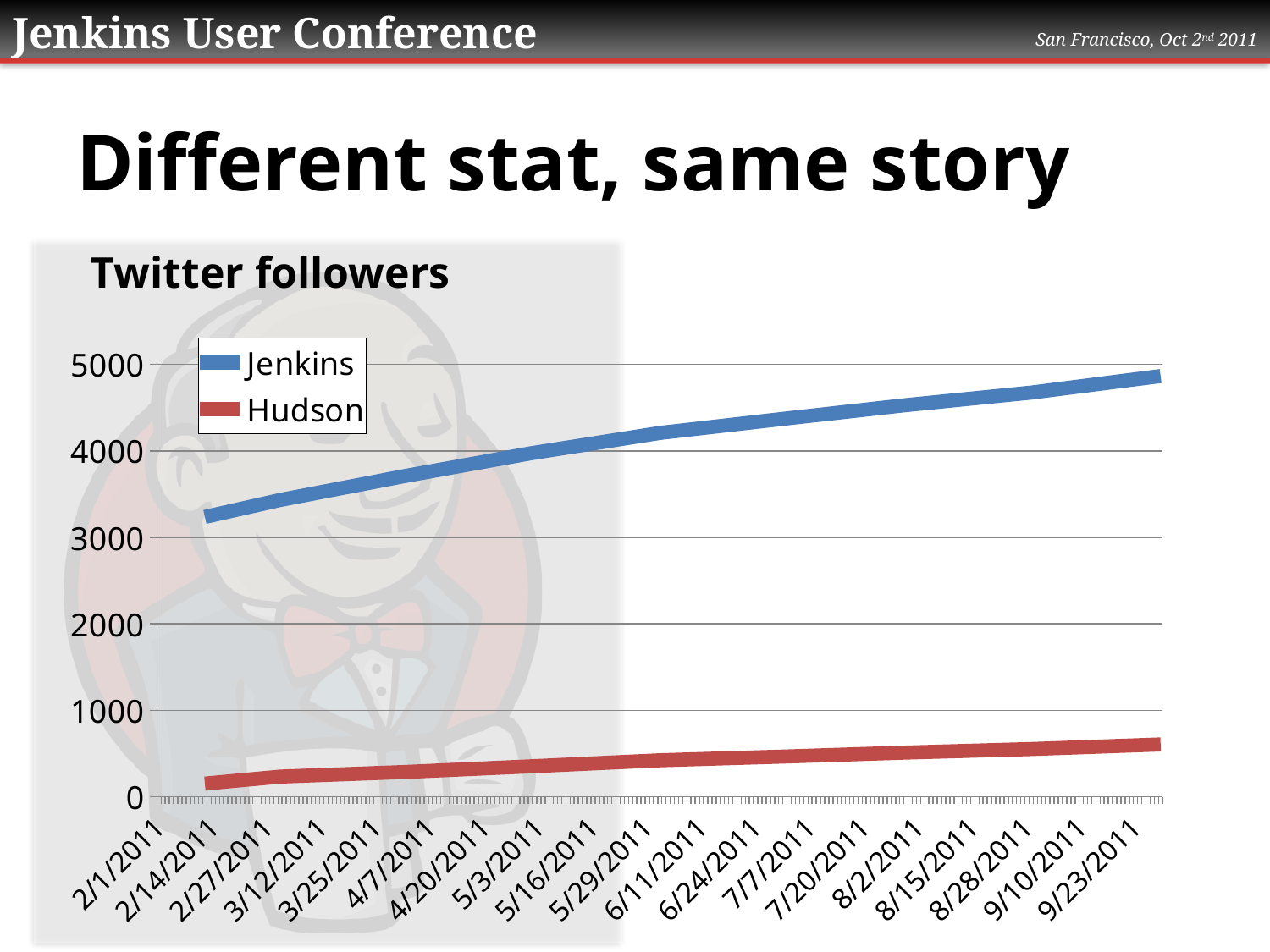
Is the value for Jenkins at 7/7/2011 greater or less than 4000? greater Which series has more Twitter followers at 9/23/2011, Jenkins or Hudson? Jenkins How many series does the legend of the chart list? 2 Is the value for Jenkins at 9/23/2011 greater or less than 4000? greater Does the Hudson line rise or fall from left to right along the x axis? rise Is the value for Hudson at 9/23/2011 greater or less than 1000? less Which colour is used for the Hudson series in the chart? red Which series has the lowest values throughout the chart? Hudson What kind of chart is shown on the slide? line chart What is the title of the chart? Twitter followers Does the Jenkins line rise or fall from left to right along the x axis? rise